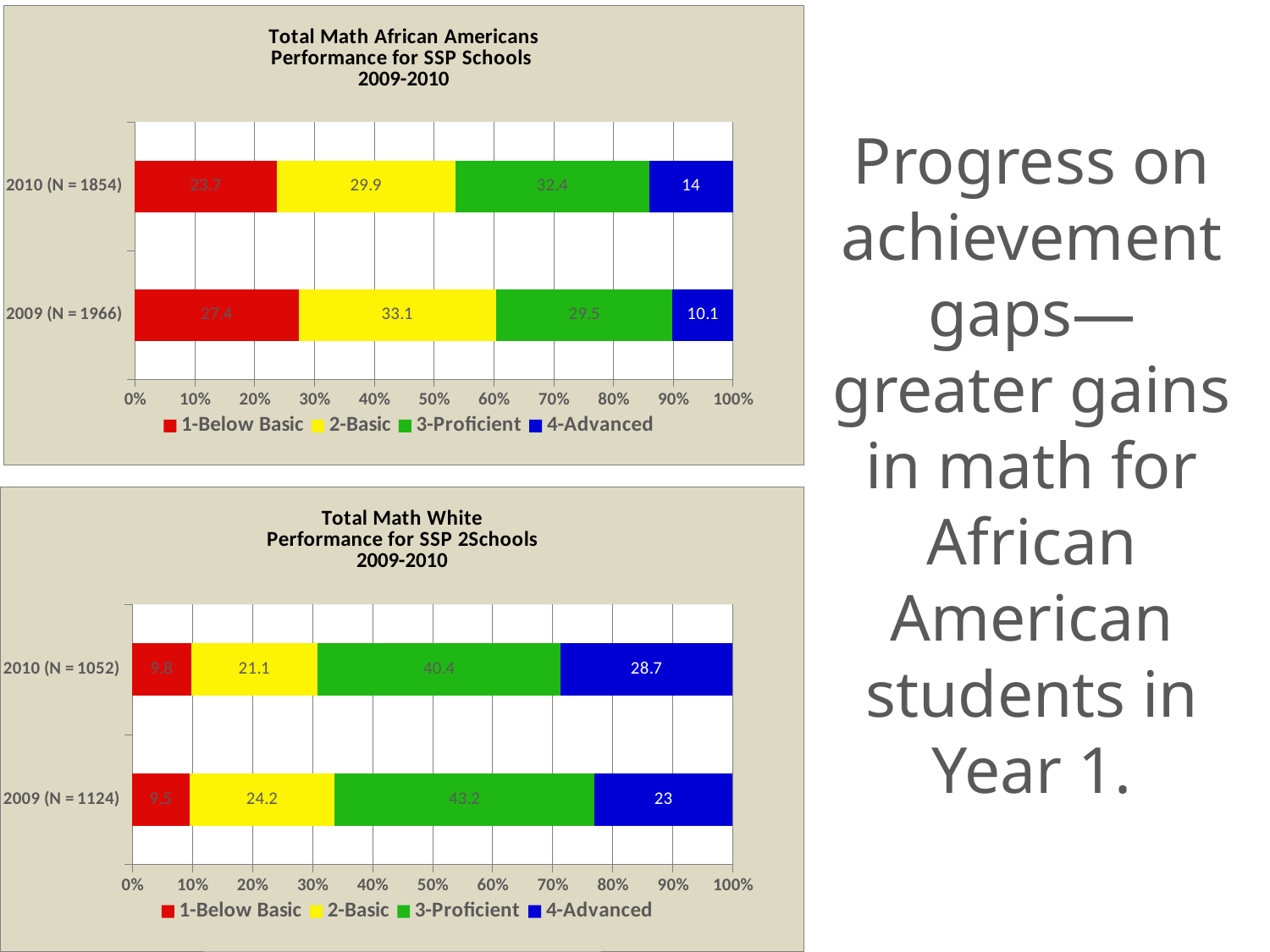
In the top chart (Total Math African Americans), what is the value for 4-Advanced in 2010 (N = 1854)? 14 In the top chart (Total Math African Americans), what is the difference between the 4-Advanced values for 2010 and 2009? 3.9 In the top chart (Total Math African Americans), which is larger for 2010: the 2-Basic value or the 3-Proficient value? 3-Proficient In the top chart (Total Math African Americans), which series has the smallest value in 2009 (N = 1966)? 4-Advanced How many series does the legend of the bottom chart (Total Math White) list? 4 In the bottom chart (Total Math White), what is the value for 3-Proficient in 2009 (N = 1124)? 43.2 In the bottom chart (Total Math White), which series has the largest value in 2010 (N = 1052)? 3-Proficient In the top chart (Total Math African Americans), what is the total of the stacked bar for 2010 (N = 1854)? 100 What kind of chart is the top chart (Total Math African Americans)? Stacked bar chart In the top chart (Total Math African Americans), what is the value for 1-Below Basic in 2009 (N = 1966)? 27.4 In the bottom chart (Total Math White), what is the difference between the 2-Basic values for 2009 and 2010? 3.1 In the bottom chart (Total Math White), what is the value for 4-Advanced in 2010 (N = 1052)? 28.7